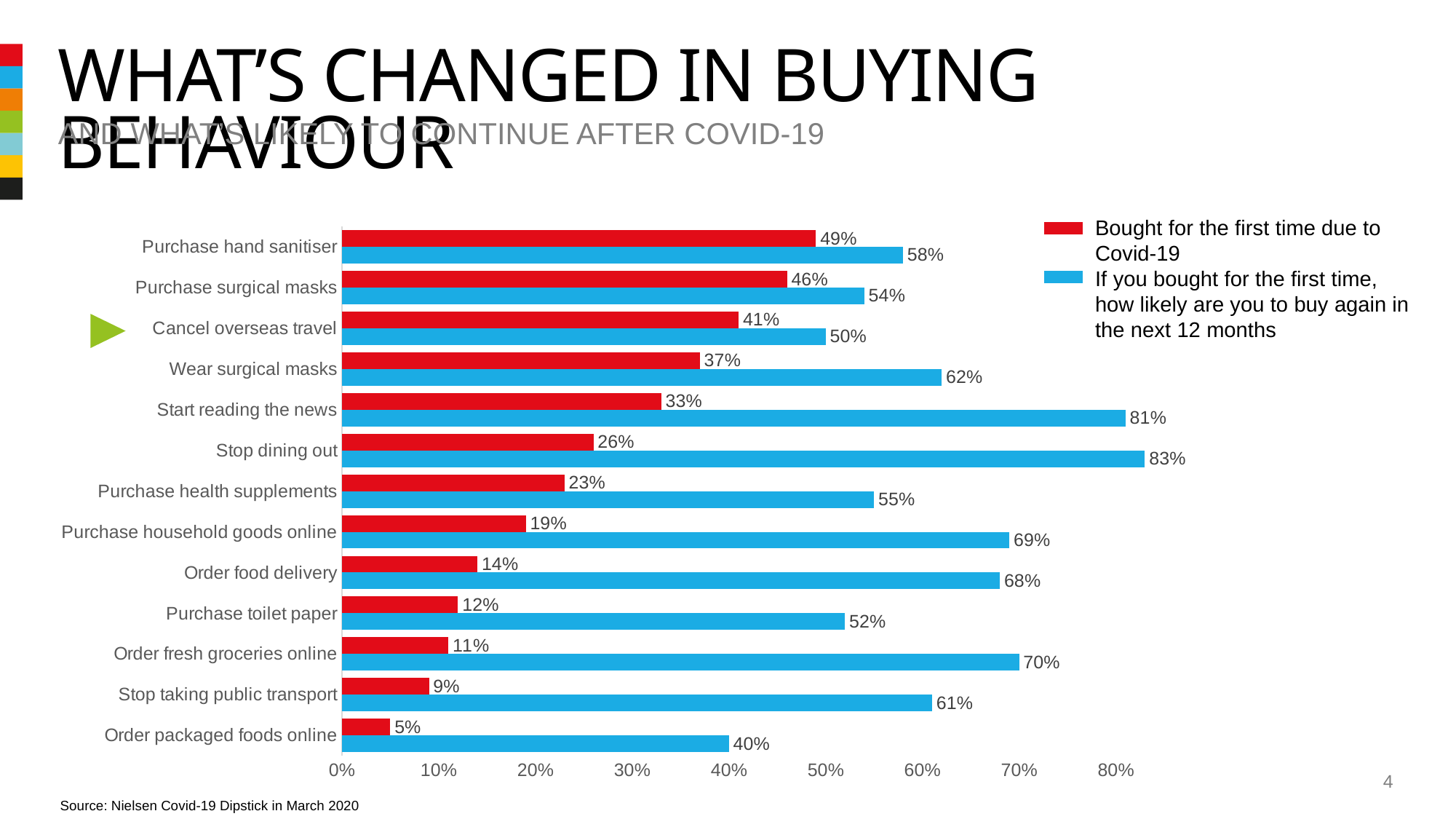
What kind of chart is shown on the slide? Bar chart How many categories are shown on the chart? 13 How many series does the legend list? 2 What is the difference between the two values shown for 'Start reading the news'? 48% What is the source cited for the chart? Nielsen Covid-19 Dipstick in March 2020 Which category has the highest value for 'Bought for the first time due to Covid-19'? Purchase hand sanitiser For 'Stop dining out', what percentage said they are likely to buy again in the next 12 months? 83% Which category has the lowest value for likelihood to buy again in the next 12 months? Order packaged foods online What colour represents 'Bought for the first time due to Covid-19'? Red Which category has the lowest value for 'Bought for the first time due to Covid-19'? Order packaged foods online Which is larger: the 'buy again' value for 'Order fresh groceries online' or for 'Purchase household goods online'? Order fresh groceries online What percentage bought hand sanitiser for the first time due to Covid-19? 49%